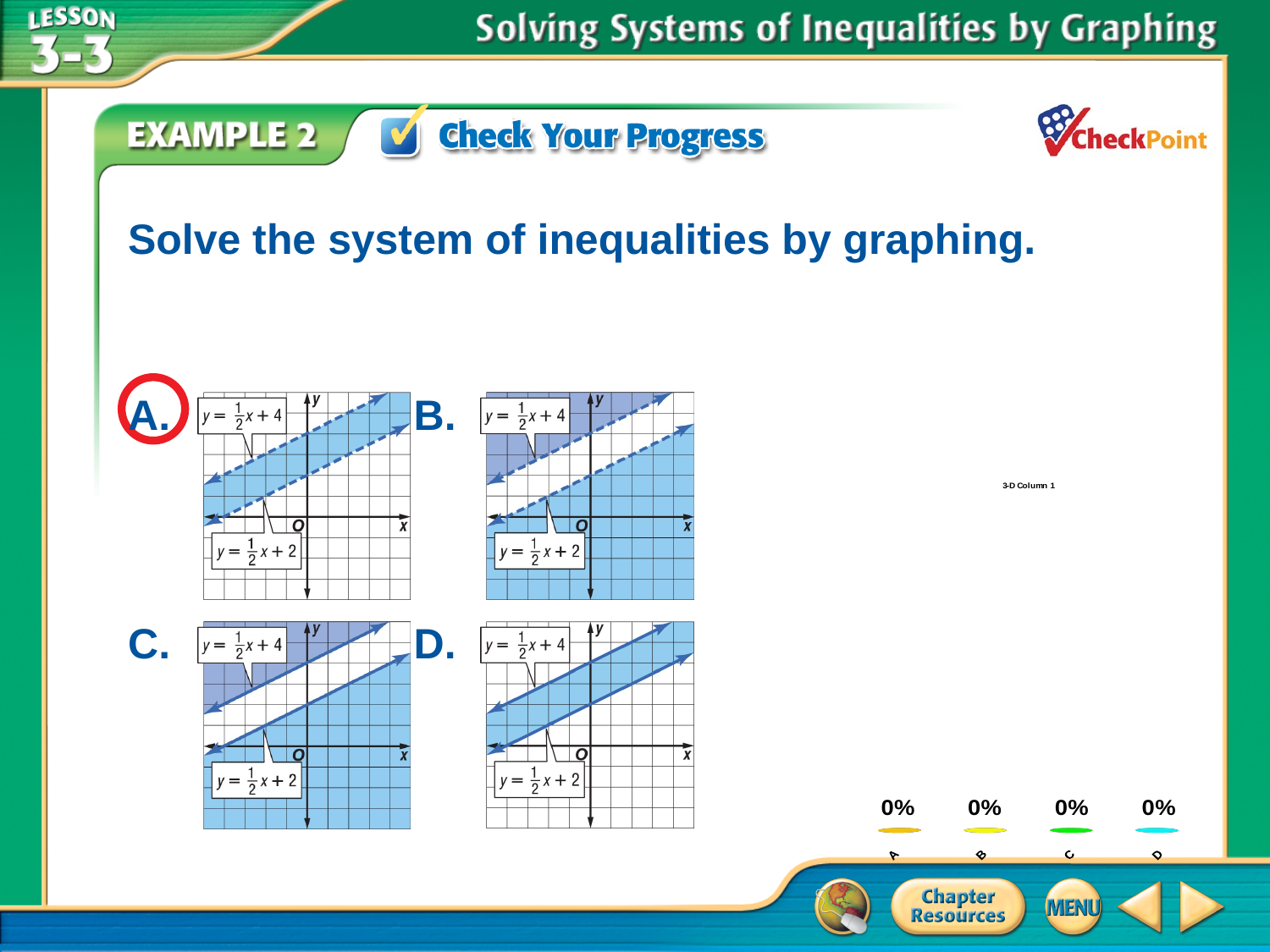
What are the category labels along the x axis of the poll chart at the bottom right of the slide? A, B, C, D On the poll chart at the bottom right of the slide, what value is shown for category B? 0% On the poll chart at the bottom right of the slide, what value is shown for category A? 0% What kind of chart is the poll chart at the bottom right of the slide? bar chart On the poll chart at the bottom right of the slide, what value is shown for category C? 0% On the poll chart at the bottom right of the slide, what value is shown for category D? 0% How many categories does the poll chart at the bottom right of the slide show? 4 On the poll chart at the bottom right of the slide, what is the difference between the values for A and D? 0%